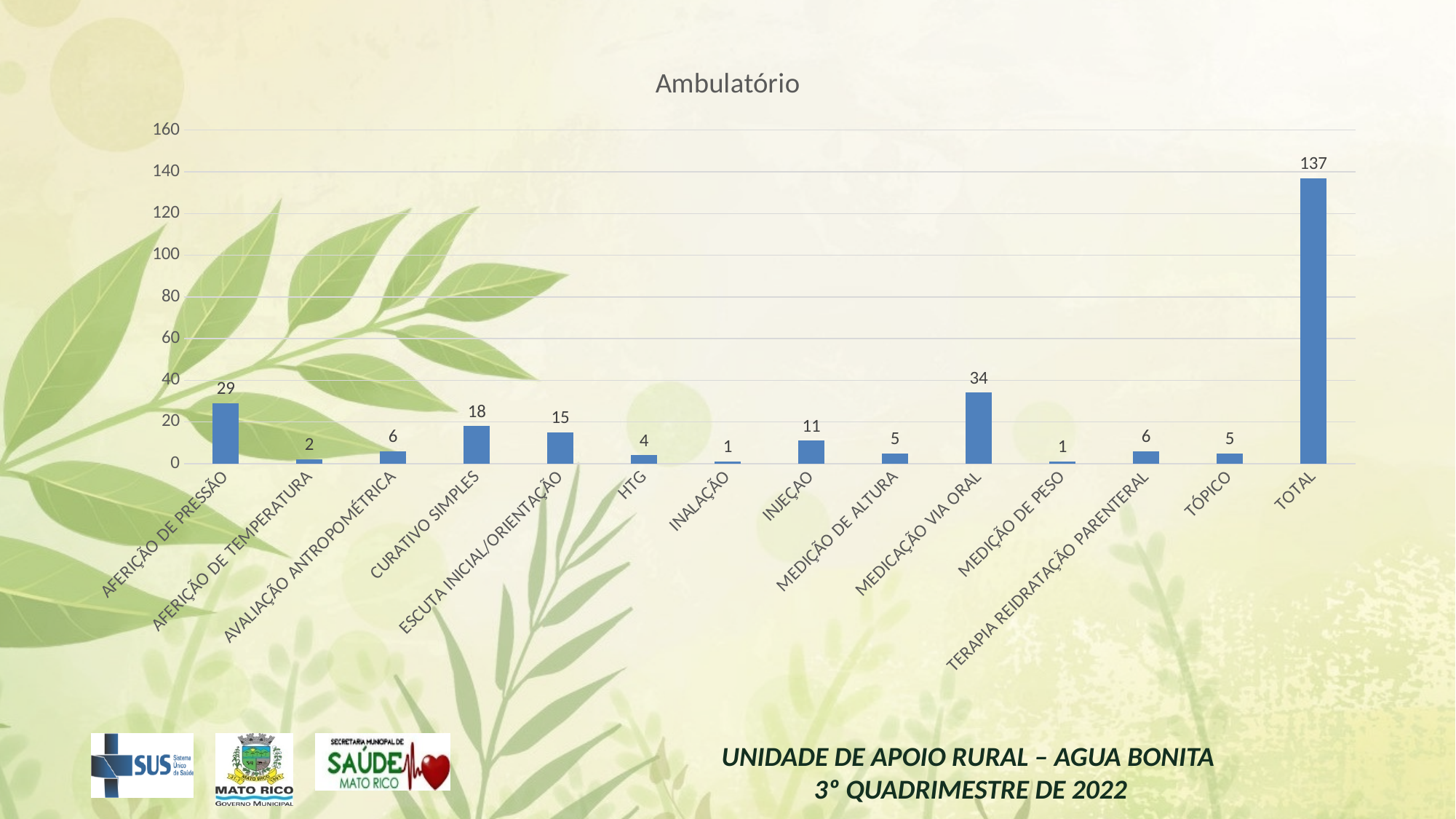
Excluding the TOTAL bar, which category has the highest value? MEDICAÇÃO VIA ORAL How many categories are shown on the x axis, including TOTAL? 14 Is the value for TOTAL greater or less than 120? greater Which is larger, ESCUTA INICIAL/ORIENTAÇÃO or INJEÇÃO? ESCUTA INICIAL/ORIENTAÇÃO Which category has the lowest value, INALAÇÃO or MEDIÇÃO DE PESO? They are equal (both 1) What is the value for CURATIVO SIMPLES? 18 What is the value for the TOTAL bar? 137 What is the value for AFERIÇÃO DE PRESSÃO? 29 What is the difference between MEDICAÇÃO VIA ORAL and AFERIÇÃO DE PRESSÃO? 5 What is the value for MEDICAÇÃO VIA ORAL? 34 What kind of chart is shown on the slide? Bar chart What is the title of the chart? Ambulatório